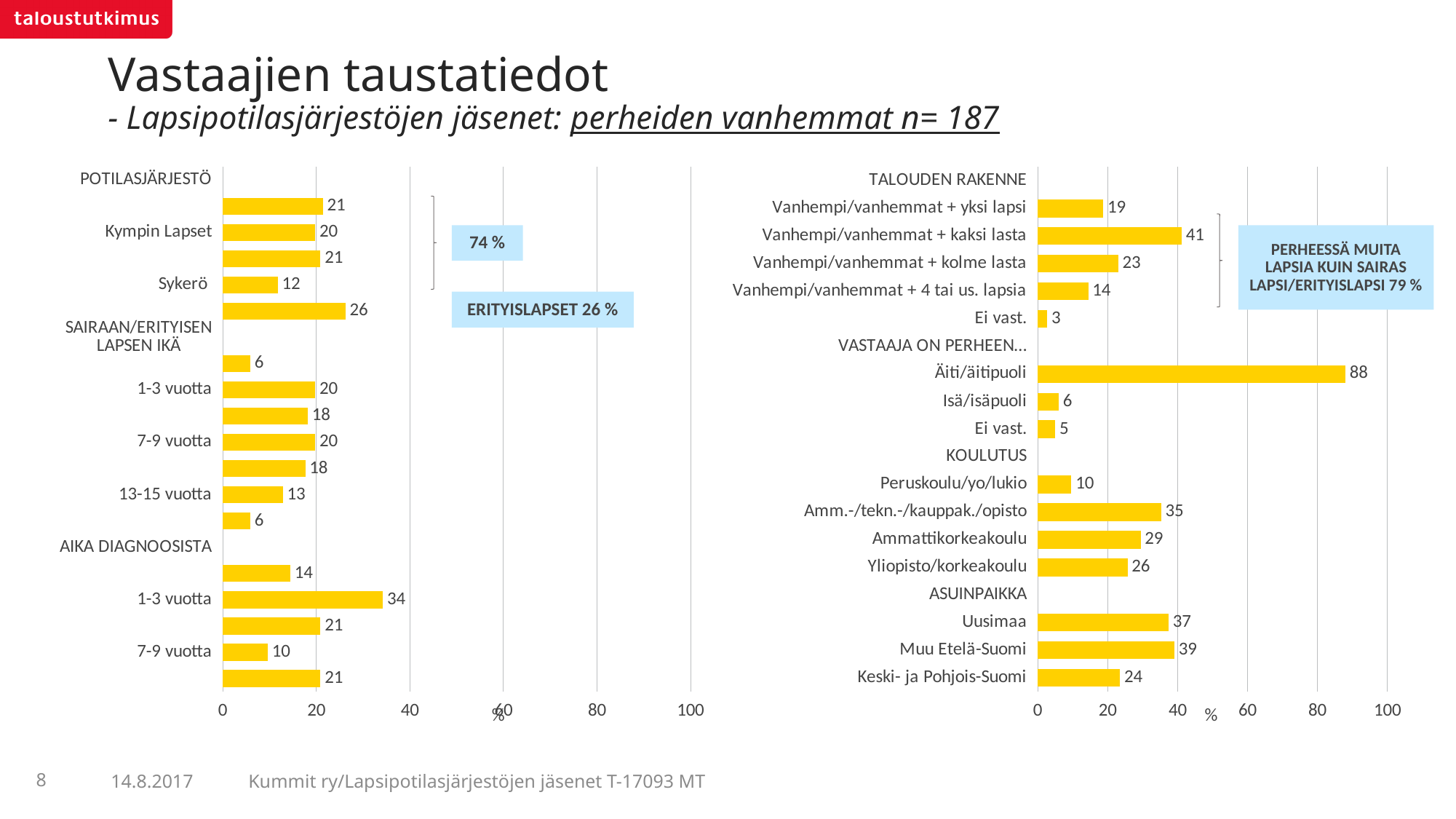
In the right chart, what is the difference between Muu Etelä-Suomi and Uusimaa? 2 What type of chart is the left chart? Bar chart In the right chart, which is larger: Amm.-/tekn.-/kauppak./opisto or Yliopisto/korkeakoulu? Amm.-/tekn.-/kauppak./opisto In the right chart, which of the ASUINPAIKKA categories has the lowest value? Keski- ja Pohjois-Suomi In the right chart, which category has the highest value? Äiti/äitipuoli In the right chart, what is the value for Ammattikorkeakoulu? 29 In the right chart, what is the value for Vanhempi/vanhemmat + kaksi lasta? 41 In the left chart, what is the value for Sykerö? 12 In the right chart, what is the value for Keski- ja Pohjois-Suomi? 24 In the right chart, what is the value for Äiti/äitipuoli? 88 In the left chart, what is the value for Kympin Lapset? 20 In the right chart, is the value for Vanhempi/vanhemmat + kolme lasta greater or less than 20? greater